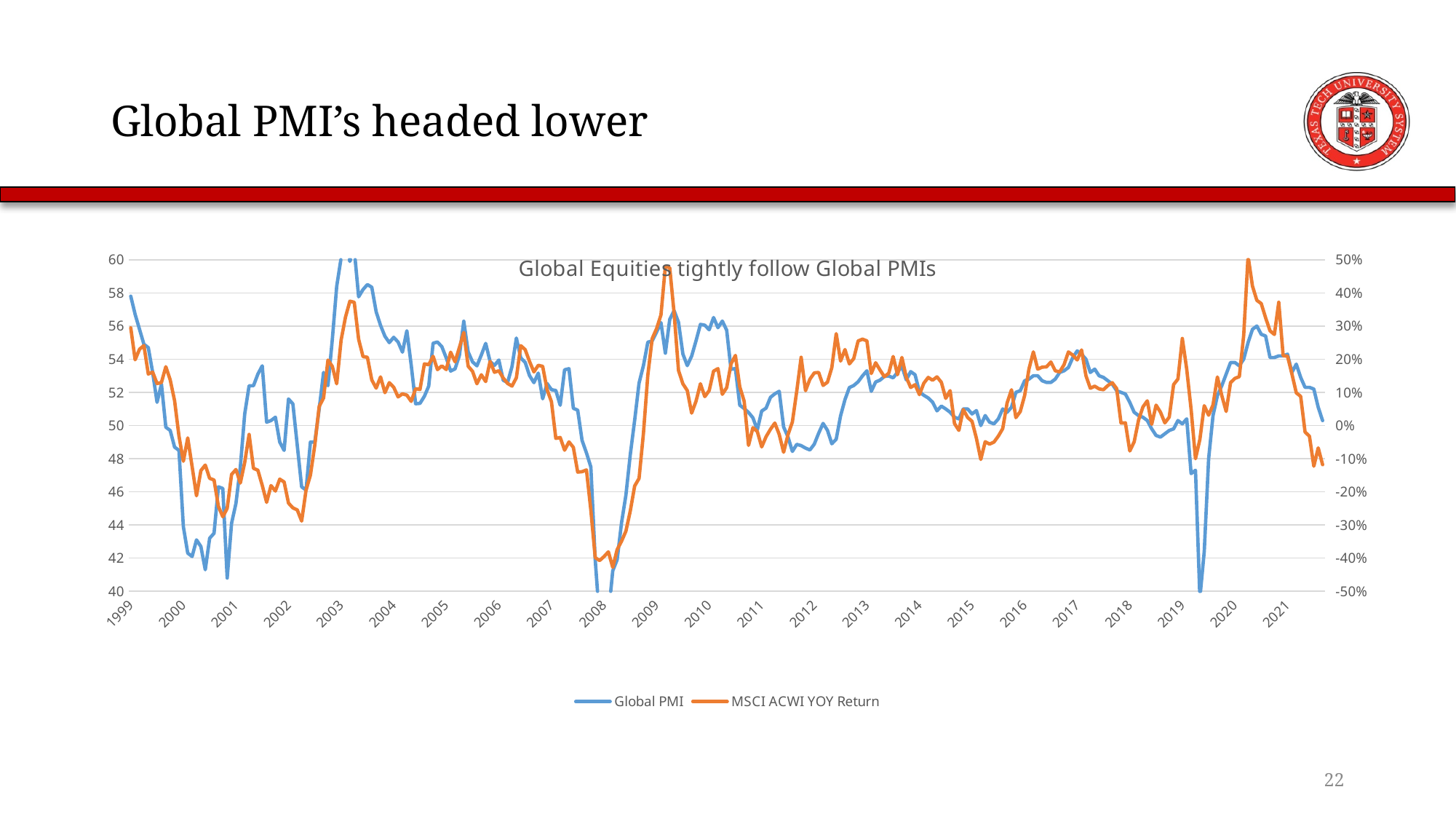
What kind of chart is shown on the slide? Line chart Which series is drawn in orange? MSCI ACWI YOY Return Is the value of Global PMI at the start of 1999 greater or less than 56? greater What is the title of the chart? Global Equities tightly follow Global PMIs Is the peak value of MSCI ACWI YOY Return around 2020-2021 greater or less than 40%? greater Is the lowest value of Global PMI around 2008-2009 greater or less than 42? less How many series does the legend list? 2 How many year labels are shown on the x axis? 23 Does the Global PMI line rise or fall from its 2020-2021 peak to the right end of the chart? fall